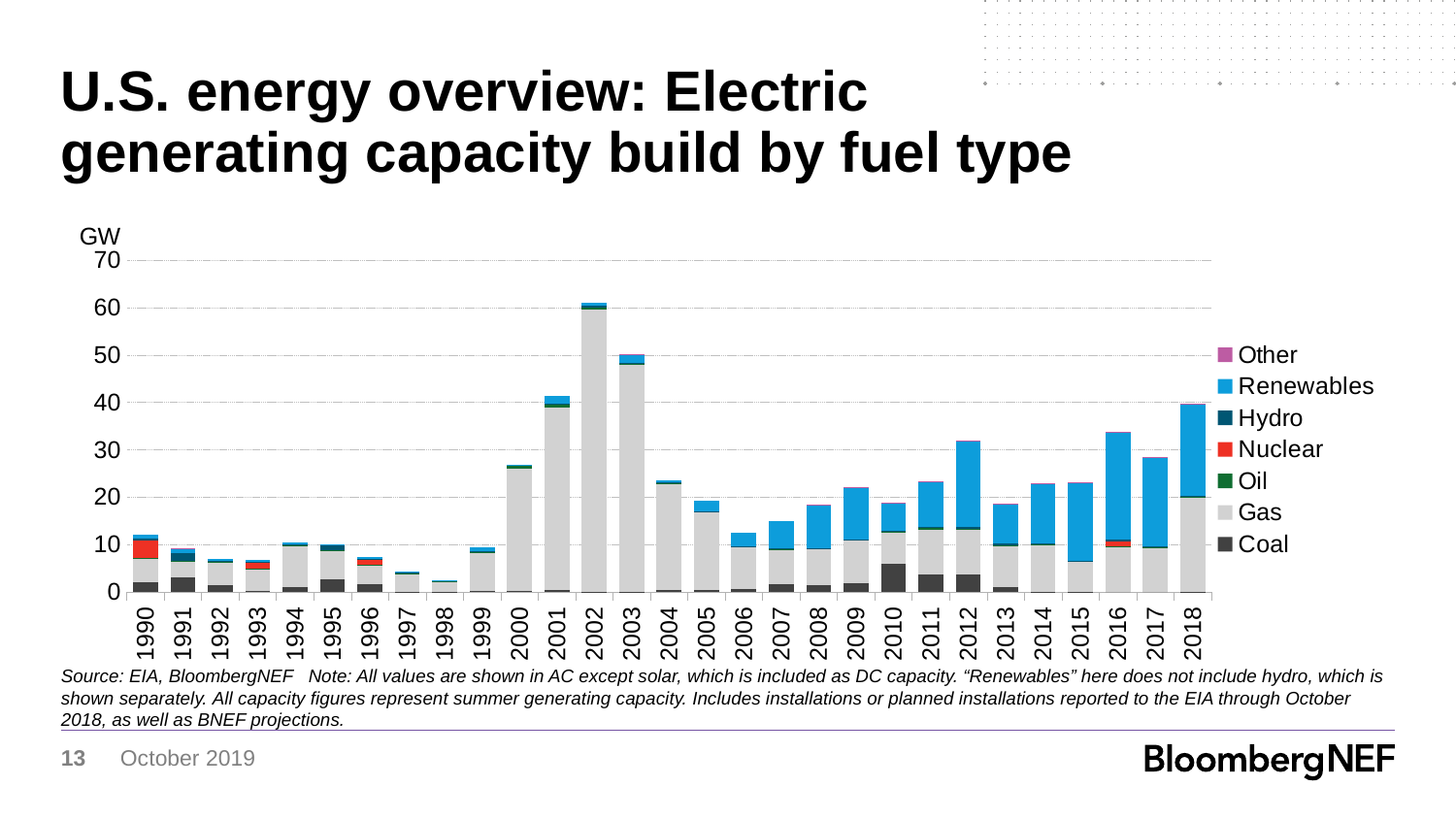
Is the total capacity build for 2002 greater or less than 50 GW? greater What kind of chart is shown on the slide? Stacked bar chart How many years are shown along the x axis? 29 Which year has a larger total capacity build, 2016 or 2017? 2016 Which year has the highest total capacity build? 2002 Is the total capacity build for 1998 greater or less than 10 GW? less Which year has the lowest total capacity build? 1998 Do the total capacity builds rise or fall from 2002 to 2006? fall What unit is shown on the y axis? GW Which year has a larger total capacity build, 2001 or 2003? 2003 Is the total capacity build for 2018 greater or less than 30 GW? greater How many series does the legend list? 7